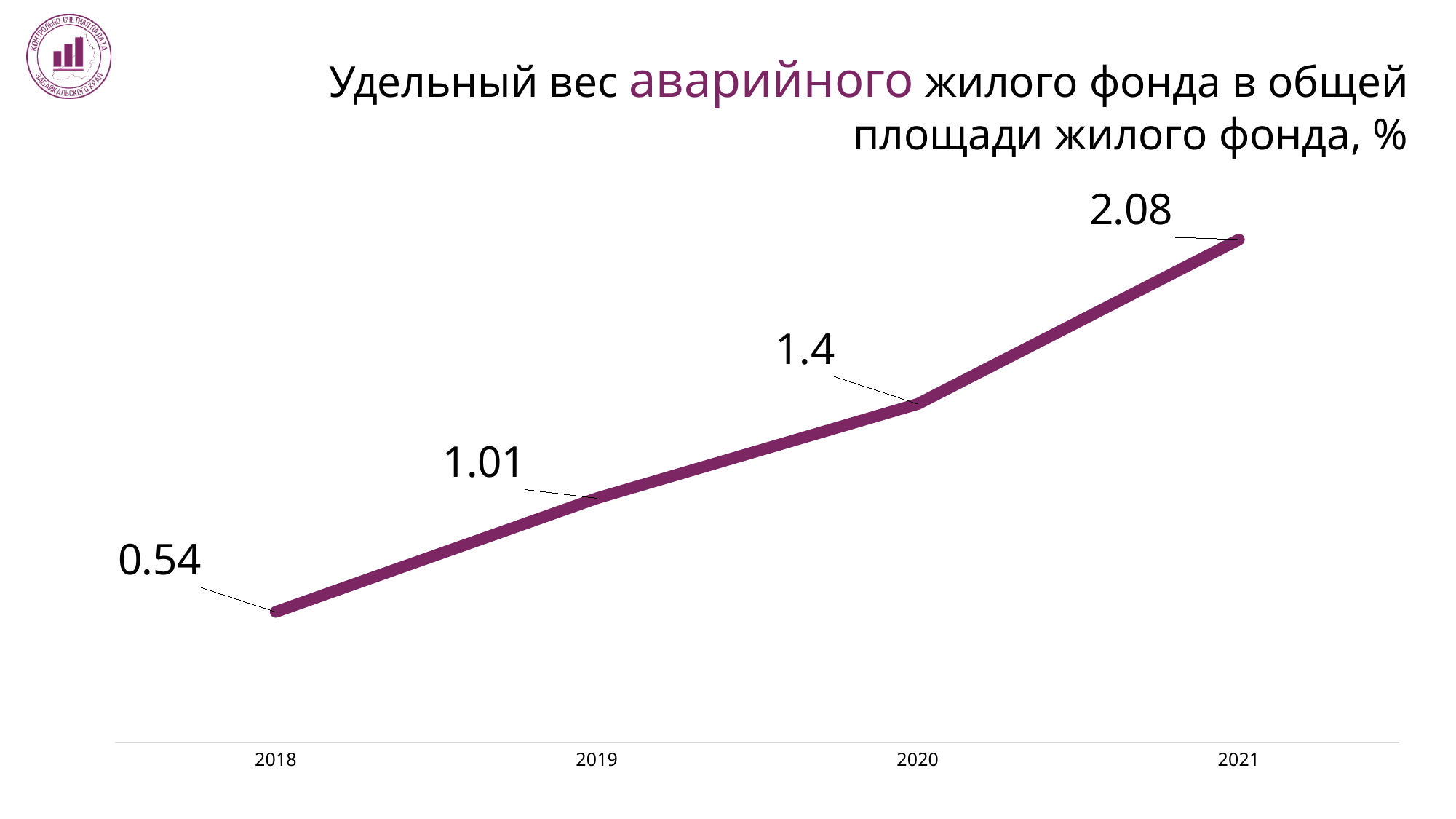
Which year has the highest value? 2021 How many years are plotted on the chart? 4 What is the value for 2019? 1.01 What is the value for 2018? 0.54 Which is larger, the value for 2019 or the value for 2020? 2020 What is the value for 2021? 2.08 Which year has the lowest value? 2018 Do the values rise or fall from 2018 to 2021? rise What is the difference between the values for 2021 and 2018? 1.54 What kind of chart is shown on the slide? line chart What is the value for 2020? 1.4 What is the difference between the values for 2020 and 2019? 0.39